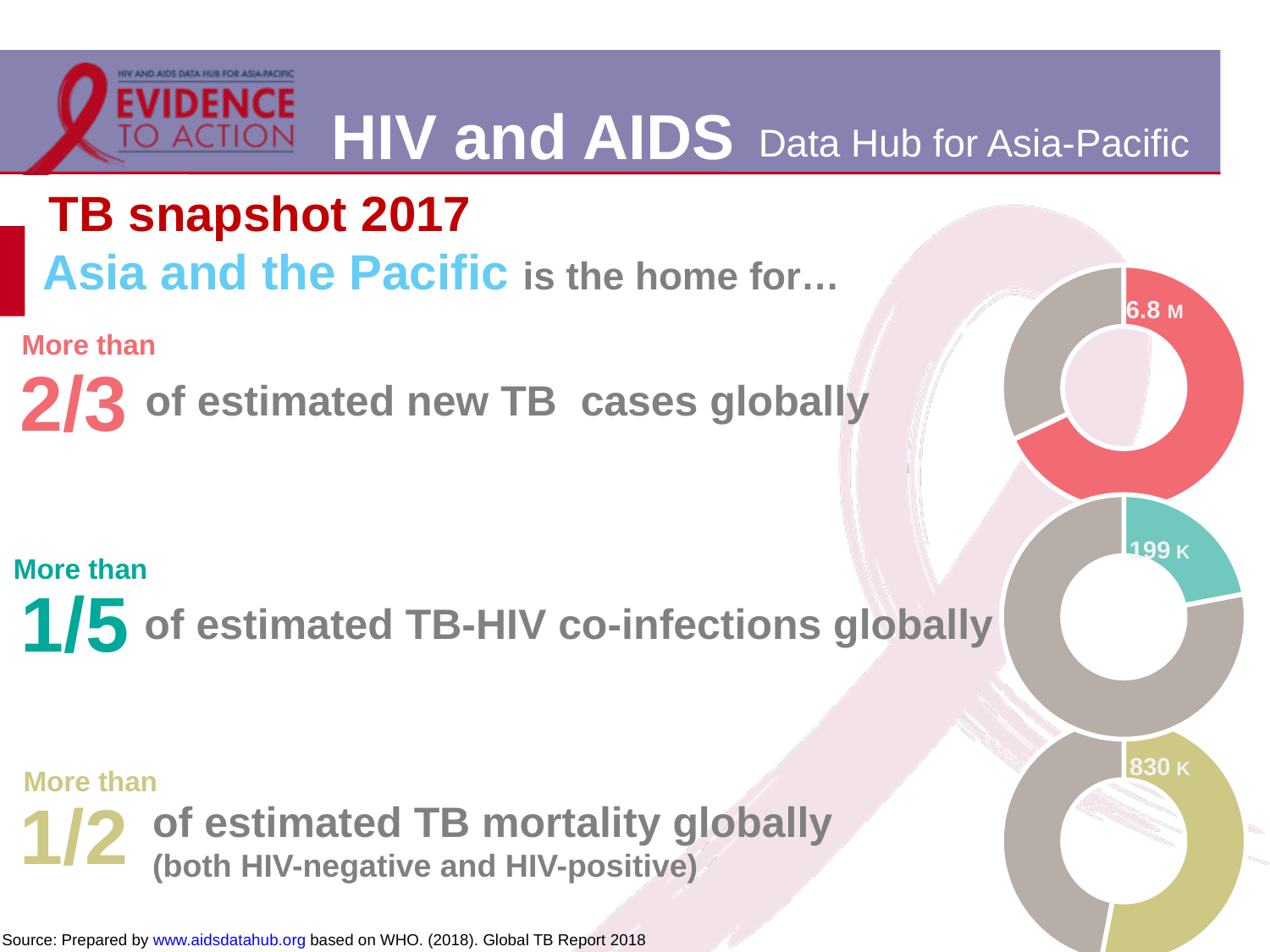
Which of the three doughnut charts has the largest printed value? The top chart (6.8 M) In the top doughnut chart, which slice is larger, the red slice or the grey slice? The red slice Which of the three doughnut charts has the smallest printed value? The middle chart (199 K) What kind of charts are shown on the right side of the slide? Doughnut (pie) charts What colour is the highlighted slice in the middle doughnut chart? Teal What colour is the highlighted slice in the bottom doughnut chart? Yellow In the bottom doughnut chart (TB mortality), what value is printed on the highlighted slice? 830 K In the middle doughnut chart, which slice is larger, the teal slice or the grey slice? The grey slice In the top doughnut chart (new TB cases), what value is printed on the highlighted slice? 6.8 M How many slices does each doughnut chart have? 2 How many doughnut charts are on the slide? 3 In the middle doughnut chart (TB-HIV co-infections), what value is printed on the highlighted slice? 199 K